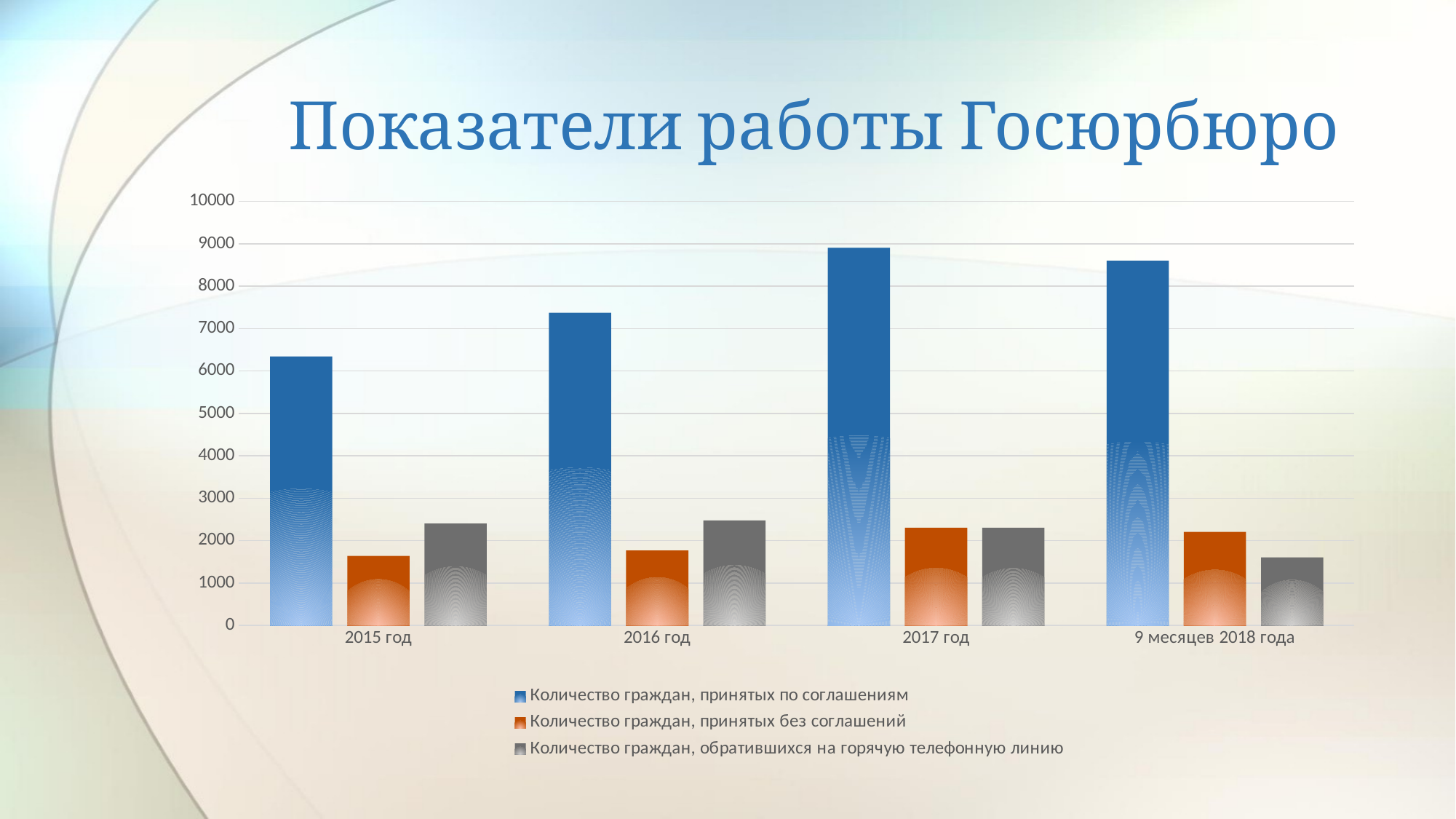
Which category has the lowest value for 'Количество граждан, обратившихся на горячую телефонную линию'? 9 месяцев 2018 года Which category has the lowest value for 'Количество граждан, принятых по соглашениям'? 2015 год What is the title of the chart on the slide? Показатели работы Госюрбюро What kind of chart is shown on the slide? Bar chart Is the value for 'Количество граждан, принятых по соглашениям' in 2016 год greater or less than 7000? greater How many series does the legend list? 3 Which category has the highest value for 'Количество граждан, принятых по соглашениям'? 2017 год Is the value for 'Количество граждан, принятых без соглашений' in 2015 год greater or less than 2000? less Does the value for 'Количество граждан, принятых по соглашениям' rise or fall from 2015 год to 2017 год? rise How many categories are shown on the x axis? 4 In 2015 год, which is larger: 'Количество граждан, принятых без соглашений' or 'Количество граждан, обратившихся на горячую телефонную линию'? Количество граждан, обратившихся на горячую телефонную линию